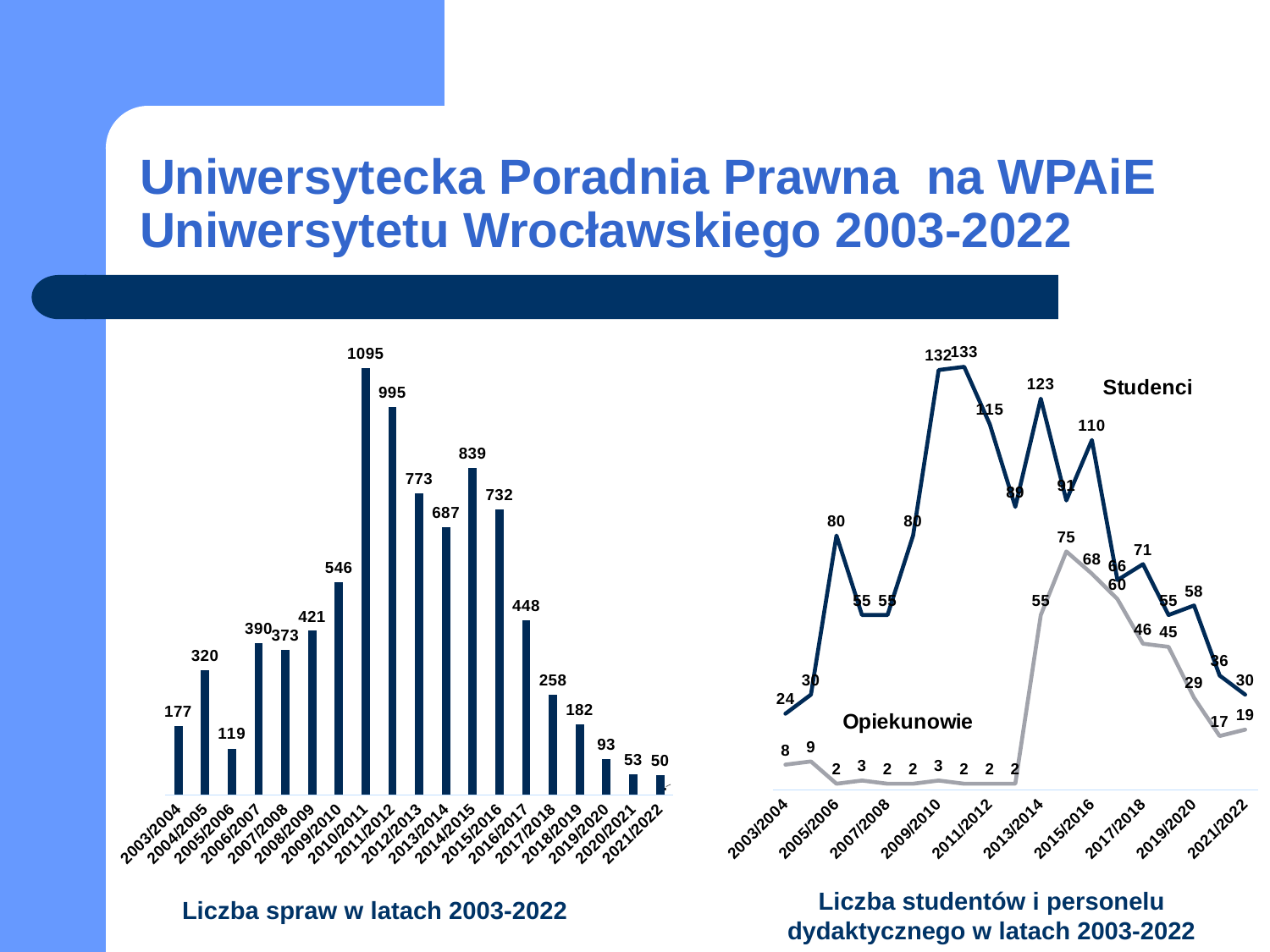
In the chart 'Liczba studentów i personelu dydaktycznego w latach 2003-2022', what is the Studenci value for 2003/2004? 24 In the chart 'Liczba spraw w latach 2003-2022', what is the value for 2003/2004? 177 In the chart 'Liczba spraw w latach 2003-2022', which year has the lowest value? 2021/2022 In the chart 'Liczba spraw w latach 2003-2022', what is the value for 2010/2011? 1095 In the chart 'Liczba studentów i personelu dydaktycznego w latach 2003-2022', what is the highest value of the Studenci series? 133 In the chart 'Liczba studentów i personelu dydaktycznego w latach 2003-2022', what is the highest value of the Opiekunowie series? 75 What kind of chart is 'Liczba studentów i personelu dydaktycznego w latach 2003-2022'? line chart In the chart 'Liczba spraw w latach 2003-2022', what is the difference between the values for 2010/2011 and 2011/2012? 100 How many years (bars) are shown in the chart 'Liczba spraw w latach 2003-2022'? 19 What kind of chart is 'Liczba spraw w latach 2003-2022'? bar chart In the chart 'Liczba spraw w latach 2003-2022', which year has the highest value? 2010/2011 In the chart 'Liczba spraw w latach 2003-2022', which is larger, the value for 2014/2015 or the value for 2013/2014? 2014/2015